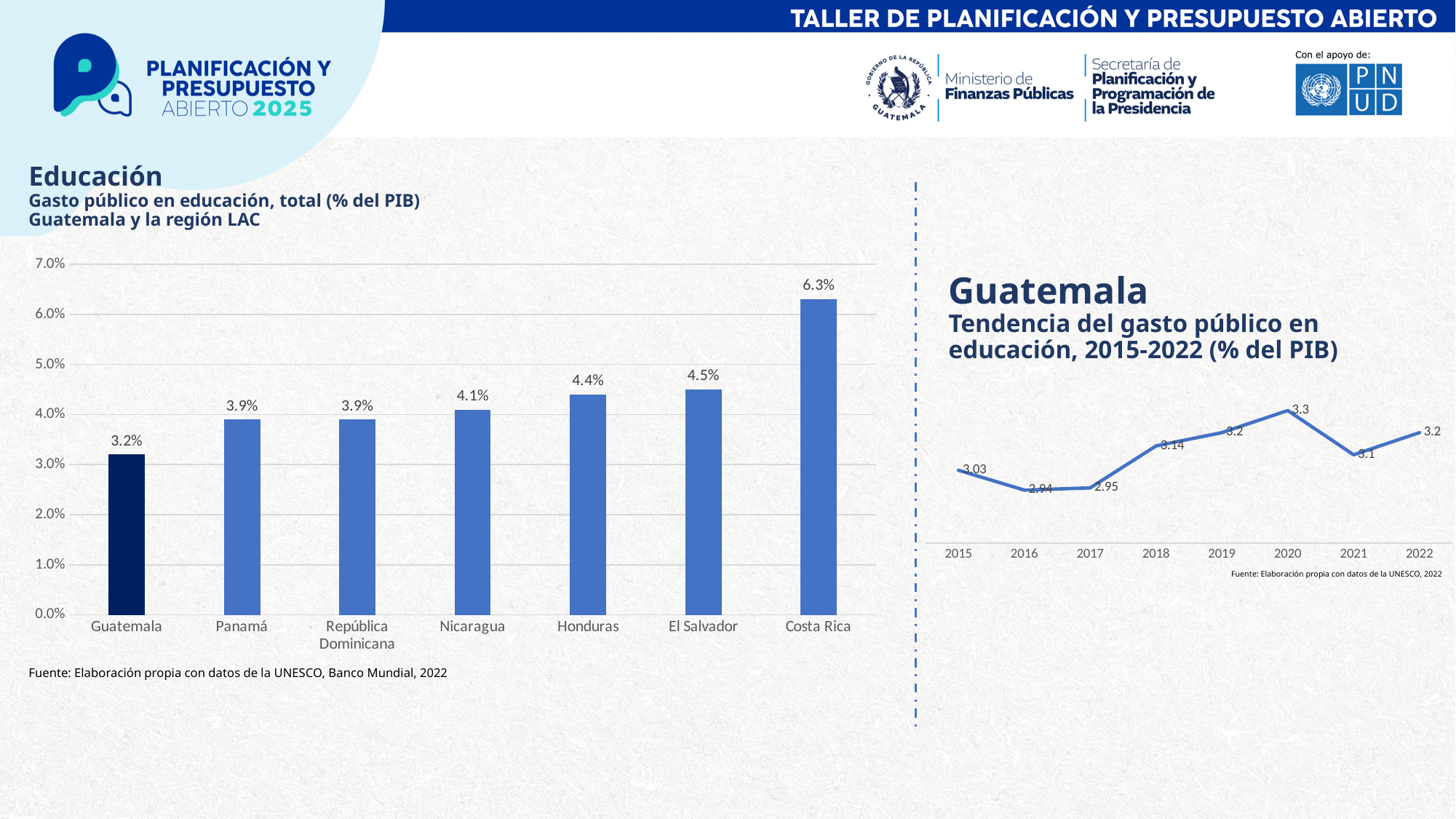
In the bar chart on the left, what is the value for Guatemala? 3.2% In the bar chart on the left, which country has the highest public spending on education as % of GDP? Costa Rica In the line chart on the right, do the values rise or fall from 2017 to 2020? Rise In the line chart on the right, how many years are plotted? 8 In the bar chart on the left, which country has the lowest value? Guatemala In the bar chart on the left, what is the difference between Costa Rica and Guatemala? 3.1% In the line chart on the right, which year has the lowest value? 2016 In the line chart on the right, what is the value for 2016? 2.94 In the bar chart on the left, which is larger, the value for Honduras or the value for Nicaragua? Honduras In the bar chart on the left, how many countries are shown? 7 What kind of chart is the chart on the left? Bar chart In the line chart on the right, which year has the highest value? 2020